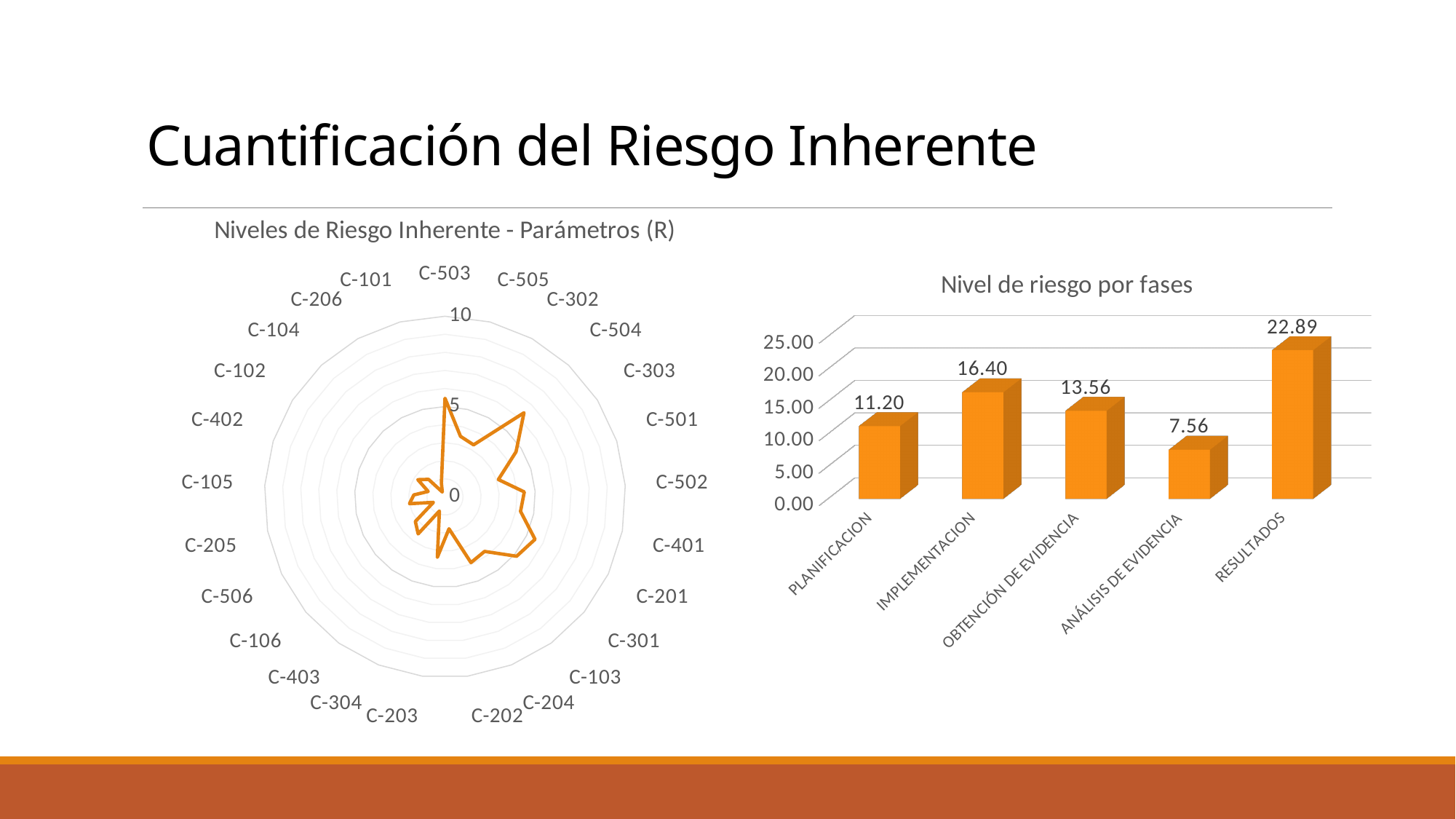
In the 'Nivel de riesgo por fases' chart, what is the difference between the values for RESULTADOS and PLANIFICACION? 11.69 In the 'Nivel de riesgo por fases' chart, which is larger, the value for IMPLEMENTACION or the value for OBTENCIÓN DE EVIDENCIA? IMPLEMENTACION What kind of chart is 'Nivel de riesgo por fases'? bar chart In the 'Niveles de Riesgo Inherente - Parámetros (R)' chart, is the value for C-105 greater or less than 5? less In the 'Nivel de riesgo por fases' chart, is the value for PLANIFICACION greater or less than 15.00? less In the 'Nivel de riesgo por fases' chart, what is the value for RESULTADOS? 22.89 In the 'Nivel de riesgo por fases' chart, which phase has the lowest value? ANÁLISIS DE EVIDENCIA In the 'Nivel de riesgo por fases' chart, which phase has the highest value? RESULTADOS In the 'Nivel de riesgo por fases' chart, what is the value for ANÁLISIS DE EVIDENCIA? 7.56 How many phases are shown in the 'Nivel de riesgo por fases' chart? 5 What kind of chart is 'Niveles de Riesgo Inherente - Parámetros (R)'? radar chart In the 'Nivel de riesgo por fases' chart, what is the value for IMPLEMENTACION? 16.40